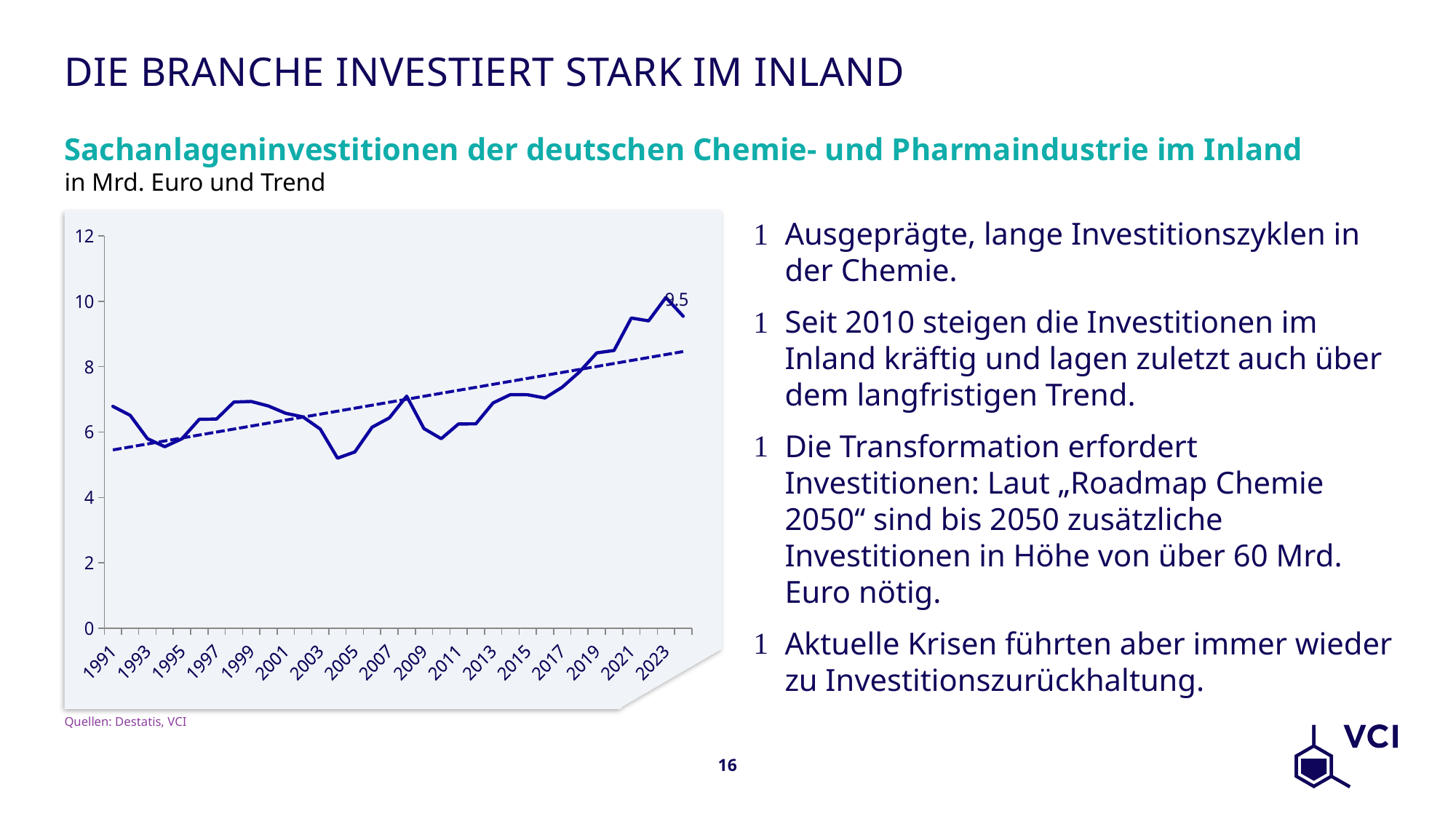
Which year has the larger value, 2001 or 2021? 2021 How many year labels are shown on the x axis? 17 Is the value for 1991 greater or less than 6? greater Which year has the larger value, 1991 or 2004? 1991 What is the value printed as a data label at the end of the line? 9.5 Does the dashed trend line rise or fall from 1991 to 2024? rise What kind of chart is shown on the slide? line chart Is the value for 2021 greater or less than 8? greater In which year does the line reach its lowest point? 2004 Is the value for 2004 greater or less than 6? less In which year does the line reach its highest point? 2023 In what unit are the values on the chart given, according to the subtitle? Mrd. Euro